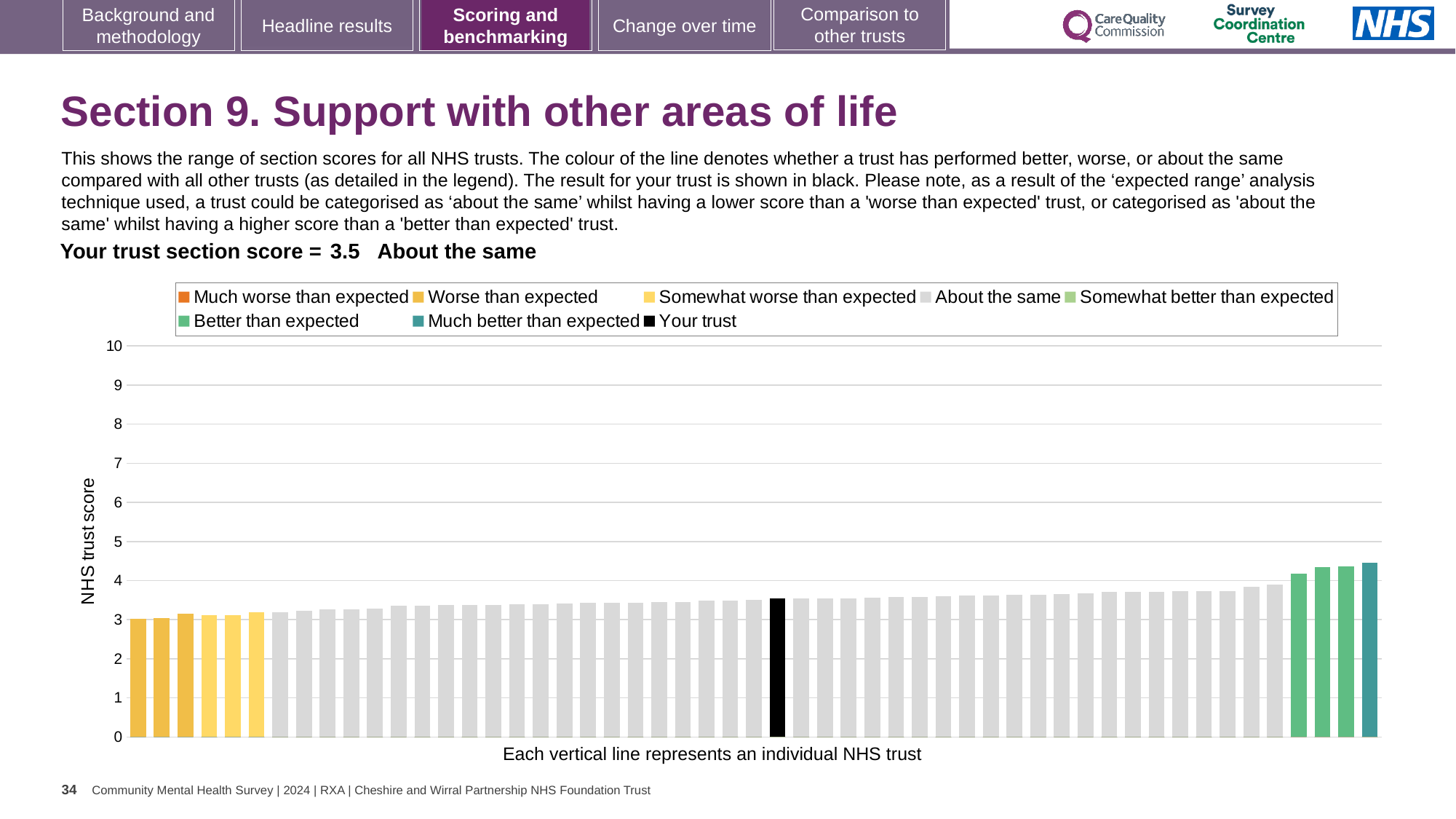
Is the value of the shortest bar greater or less than 2? greater Which is larger, the leftmost bar or the rightmost bar? the rightmost bar Which legend category does the tallest bar belong to? Much better than expected What kind of chart is shown on the slide? bar chart What is the label on the y axis of the chart? NHS trust score What is the section score for your trust shown on the slide? 3.5 Do the bar values rise or fall from left to right along the x axis? rise Is the value of the tallest bar greater or less than 4? greater How many entries does the chart legend list? 8 How many bars are coloured as 'Much better than expected'? 1 Is the value for your trust (the black bar) greater or less than 4? less What colour is the bar representing your trust? black